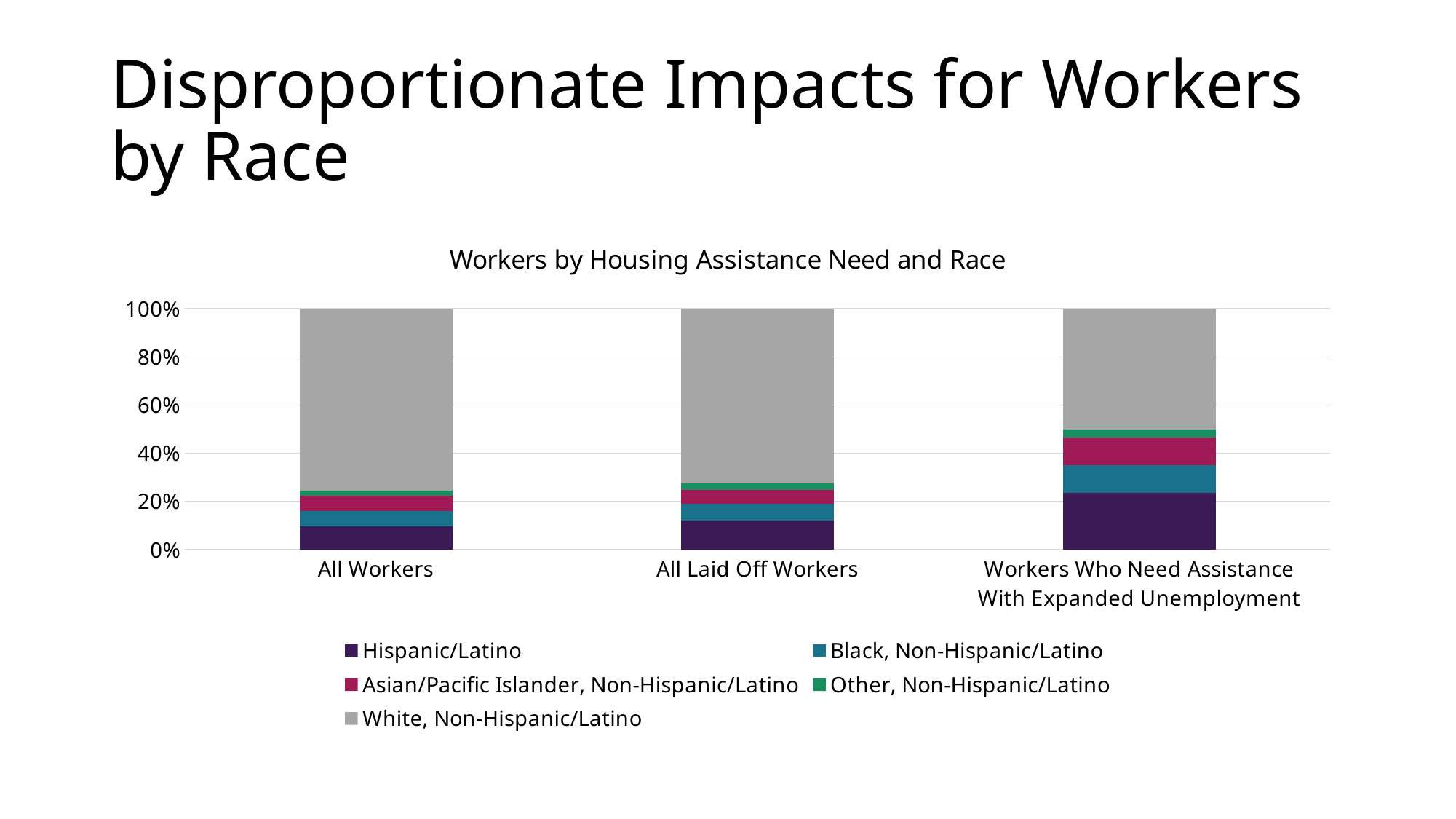
What is the title of the chart? Workers by Housing Assistance Need and Race Which category has the largest Hispanic/Latino share? Workers Who Need Assistance With Expanded Unemployment Is the Hispanic/Latino share larger for All Workers or for Workers Who Need Assistance With Expanded Unemployment? Workers Who Need Assistance With Expanded Unemployment Is the Hispanic/Latino share for All Workers greater or less than 20%? less Is the White, Non-Hispanic/Latino share for All Workers greater or less than 60%? greater Is the Hispanic/Latino share for Workers Who Need Assistance With Expanded Unemployment greater or less than 20%? greater How many series does the legend list? 5 Does the Hispanic/Latino share rise or fall moving from All Workers to Workers Who Need Assistance With Expanded Unemployment? rise How many categories are shown along the x axis? 3 What type of chart is shown on the slide? Stacked bar chart Which category has the smallest White, Non-Hispanic/Latino share? Workers Who Need Assistance With Expanded Unemployment